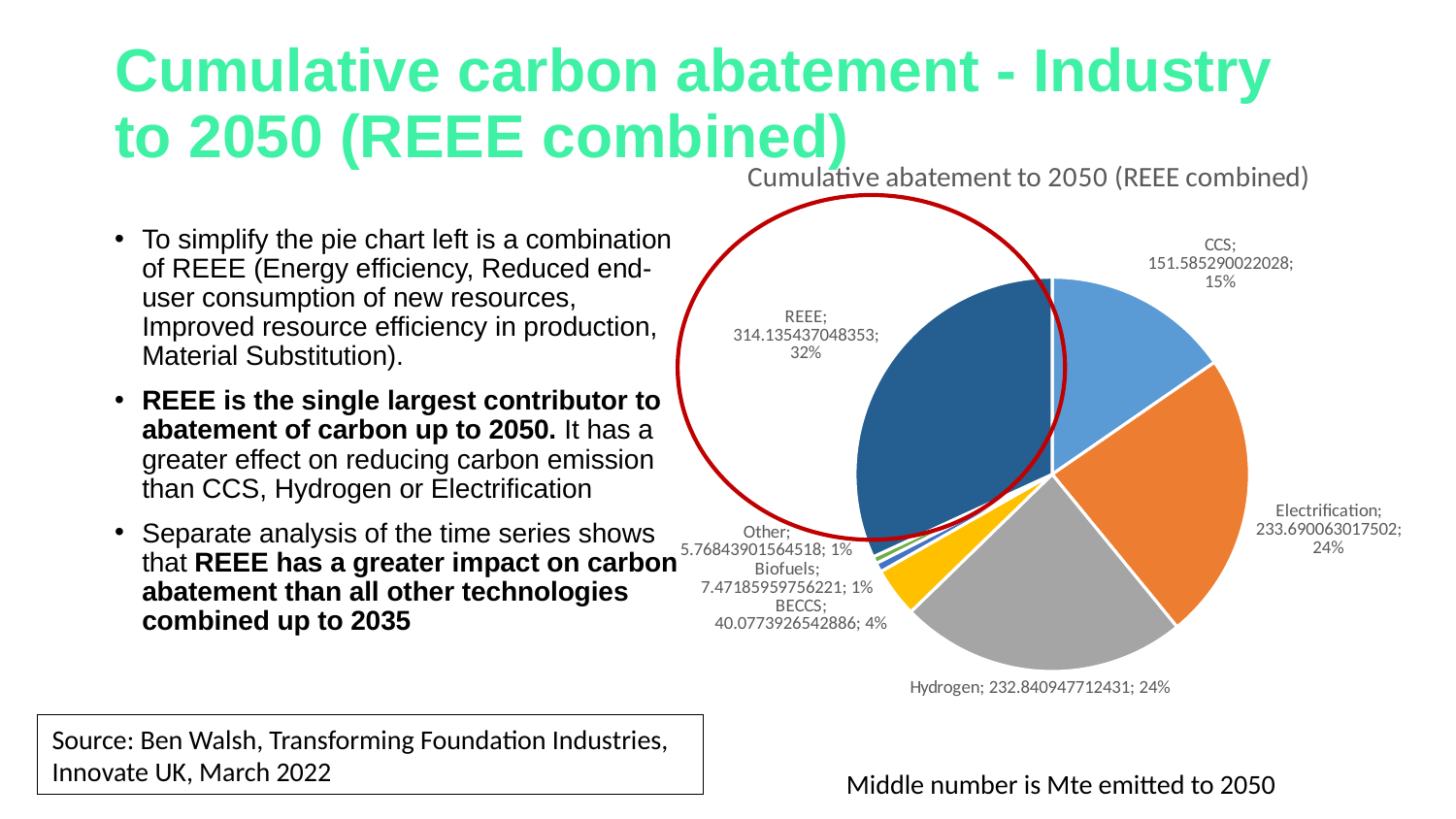
Which is larger, the REEE slice or the CCS slice? REEE How many categories (slices) does the pie chart have? 7 What percentage share does the Electrification slice have? 24% Which category has the largest slice of the pie? REEE What value is shown for the BECCS slice? 40.0773926542886 What value is shown for the REEE slice? 314.135437048353 What type of chart is shown on the slide? Pie chart What percentage share does the REEE slice have? 32% Which category has the smallest slice of the pie? Other What value is shown for the CCS slice? 151.585290022028 What is the title of the chart? Cumulative abatement to 2050 (REEE combined) By how many percentage points does the REEE share exceed the CCS share? 17 percentage points